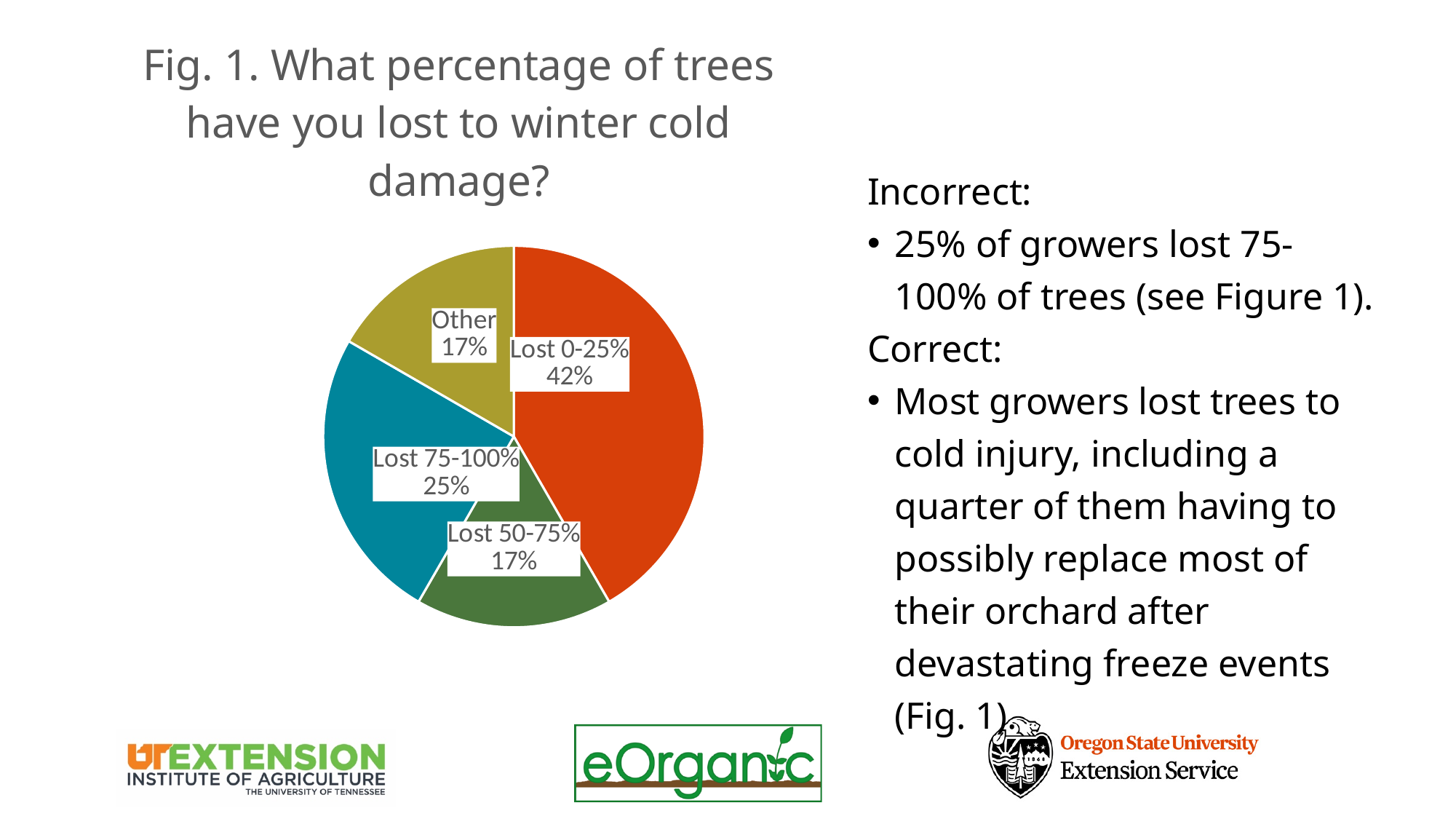
What share of the pie is labelled "Lost 0-25%"? 42% What kind of chart is shown on the slide? pie chart What is the title of the chart? Fig. 1. What percentage of trees have you lost to winter cold damage? How many slices does the pie chart have? 4 Which slice of the pie is the largest? Lost 0-25% What share of the pie is labelled "Other"? 17% What colour is the "Lost 0-25%" slice? orange-red What is the difference between the "Lost 0-25%" share and the "Lost 75-100%" share? 17% What is the difference between the "Lost 75-100%" share and the "Other" share? 8% Which is larger, the "Lost 75-100%" slice or the "Lost 50-75%" slice? Lost 75-100% What share of the pie is labelled "Lost 75-100%"? 25%